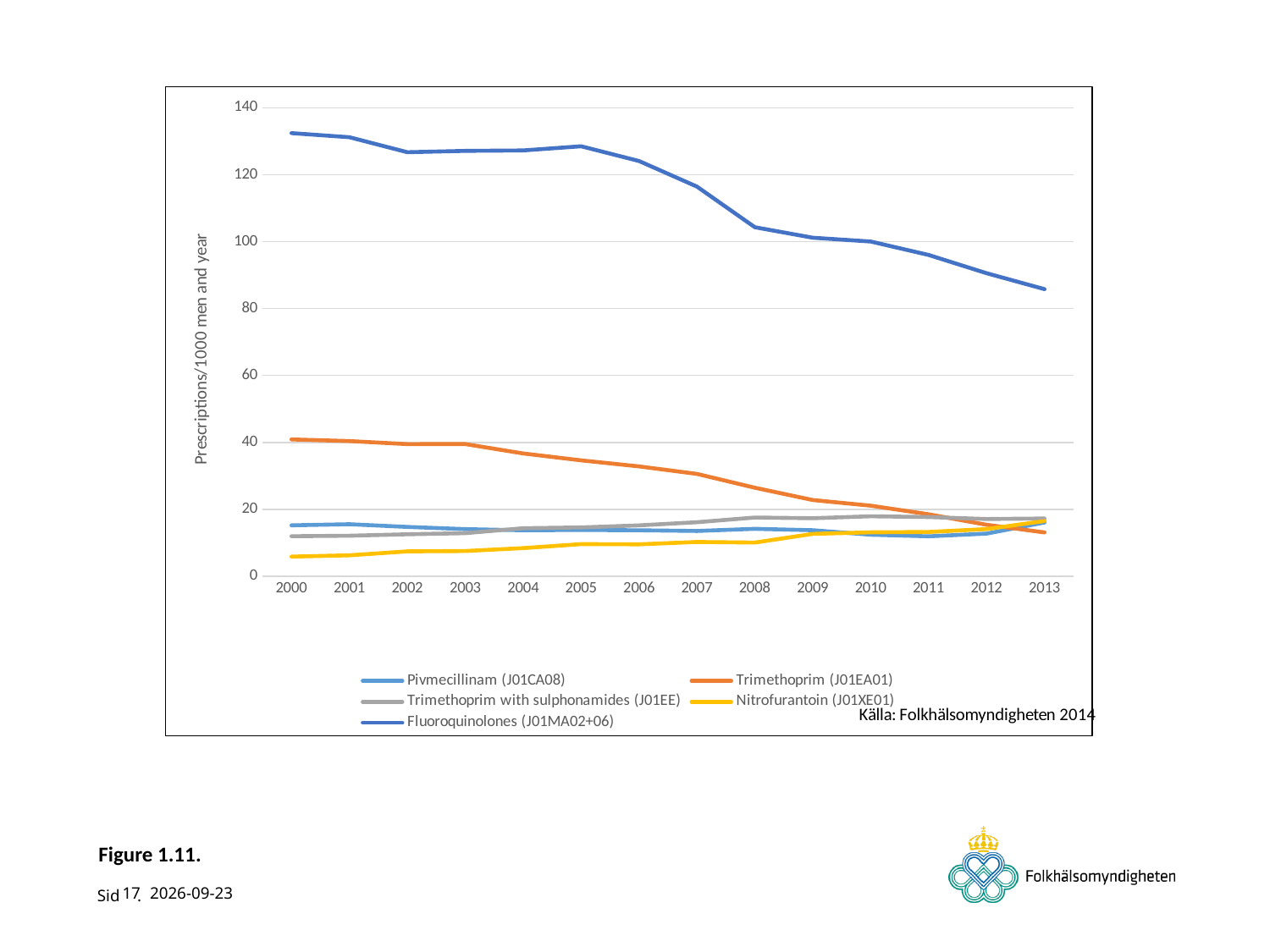
Is the value for Fluoroquinolones (J01MA02+06) in 2013 greater or less than 100? less Does the value for Nitrofurantoin (J01XE01) rise or fall from 2000 to 2013? rise Does the value for Fluoroquinolones (J01MA02+06) rise or fall from 2000 to 2013? fall Which series has the highest value in 2000? Fluoroquinolones (J01MA02+06) Which series has the lowest value in 2000? Nitrofurantoin (J01XE01) Does the value for Trimethoprim (J01EA01) rise or fall from 2000 to 2013? fall In 2000, which is larger: Trimethoprim (J01EA01) or Pivmecillinam (J01CA08)? Trimethoprim (J01EA01) How many series does the legend list? 5 What is the label of the y axis? Prescriptions/1000 men and year What kind of chart is shown on the slide? line chart How many years are plotted along the x axis? 14